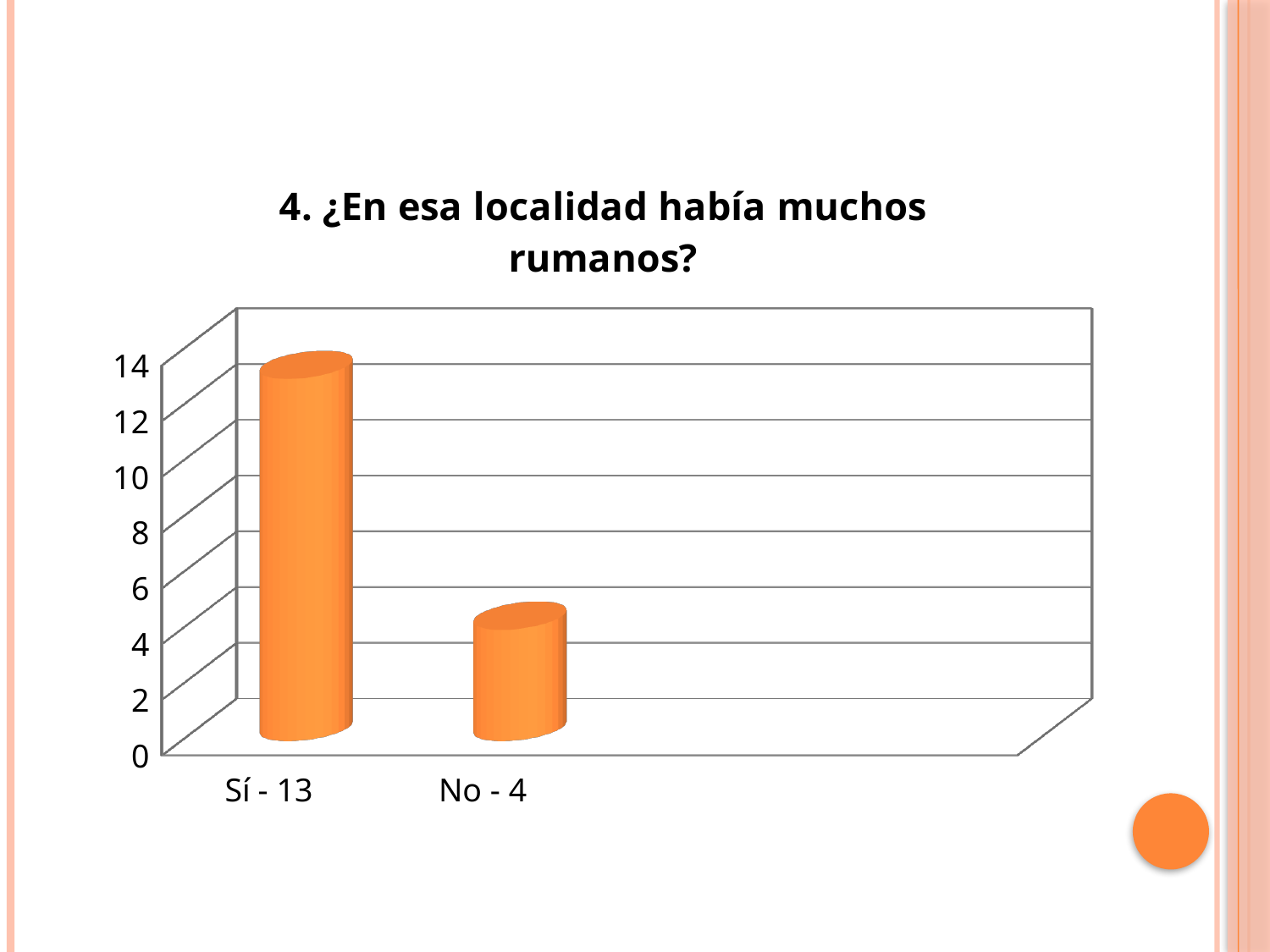
Is the value for "Sí" greater or less than 10? greater How many categories are shown in the chart? 2 What is the title of the chart? 4. ¿En esa localidad había muchos rumanos? Which category has the lowest value? No What is the value for "Sí"? 13 Which is larger, the value for "Sí" or the value for "No"? Sí What is the difference between the values for "Sí" and "No"? 9 What is the value for "No"? 4 Which category has the highest value? Sí Is the value for "No" greater or less than 6? less What kind of chart is shown on the slide? bar chart What is the highest value shown on the vertical axis? 14